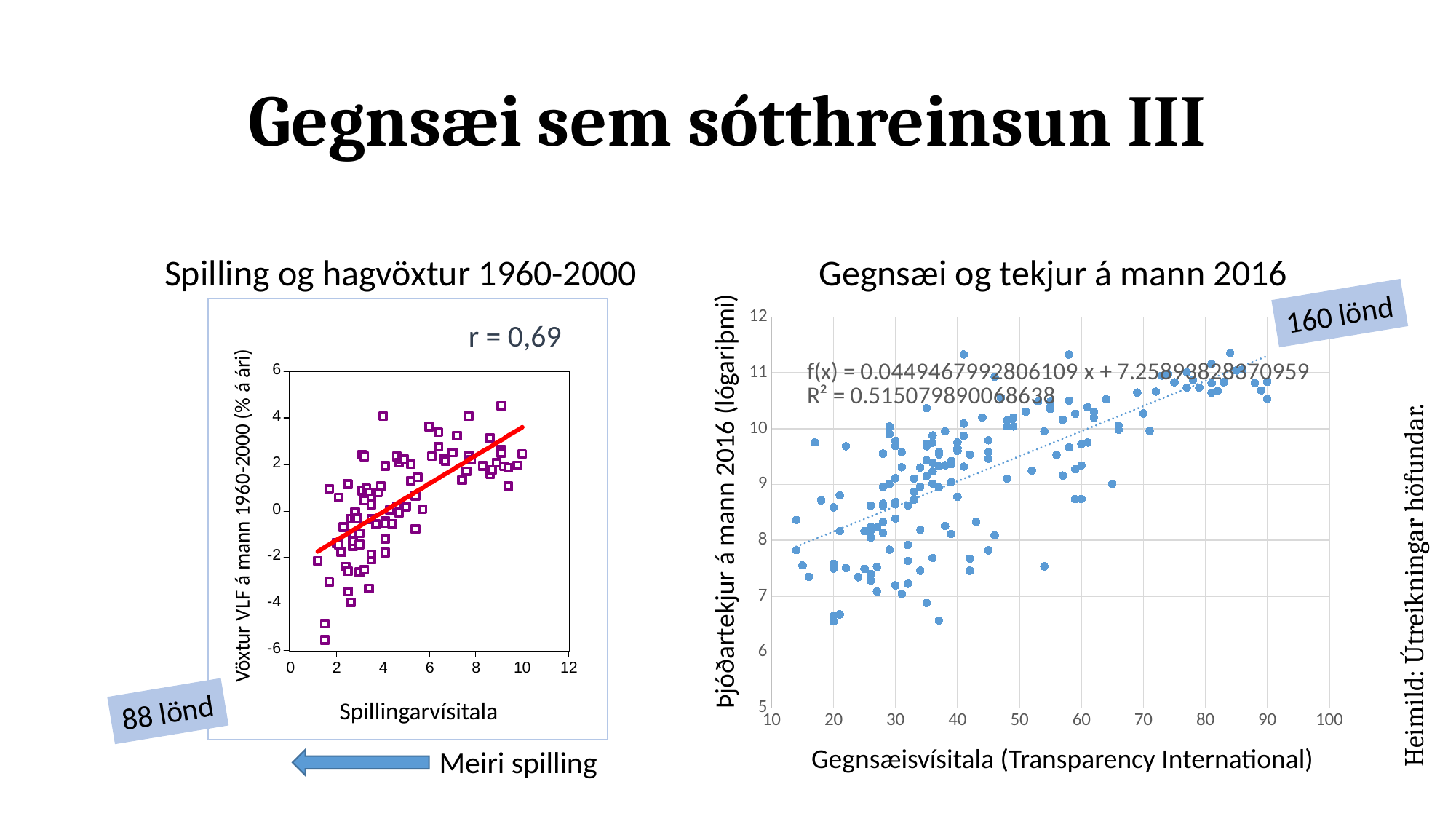
How many countries (lönd) are plotted in the left chart "Spilling og hagvöxtur 1960-2000"? 88 lönd What kind of chart is the left chart titled "Spilling og hagvöxtur 1960-2000"? scatter chart In the right chart "Gegnsæi og tekjur á mann 2016", do the values generally rise or fall as the x axis (Gegnsæisvísitala) increases? rise In the right chart "Gegnsæi og tekjur á mann 2016", what is the equation of the fitted line shown? f(x) = 0.0449467992806109 x + 7.25898828370959 What is the x-axis label of the right chart "Gegnsæi og tekjur á mann 2016"? Gegnsæisvísitala (Transparency International) In the right chart "Gegnsæi og tekjur á mann 2016", what R² value is printed for the trend line? 0.515079890068638 In the left chart "Spilling og hagvöxtur 1960-2000", what correlation coefficient r is printed? r = 0,69 What kind of chart is the right chart titled "Gegnsæi og tekjur á mann 2016"? scatter chart What is the y-axis label of the left chart "Spilling og hagvöxtur 1960-2000"? Vöxtur VLF á mann 1960-2000 (% á ári) In the left chart "Spilling og hagvöxtur 1960-2000", do the values generally rise or fall as the x axis (Spillingarvísitala) increases? rise How many countries (lönd) are plotted in the right chart "Gegnsæi og tekjur á mann 2016"? 160 lönd